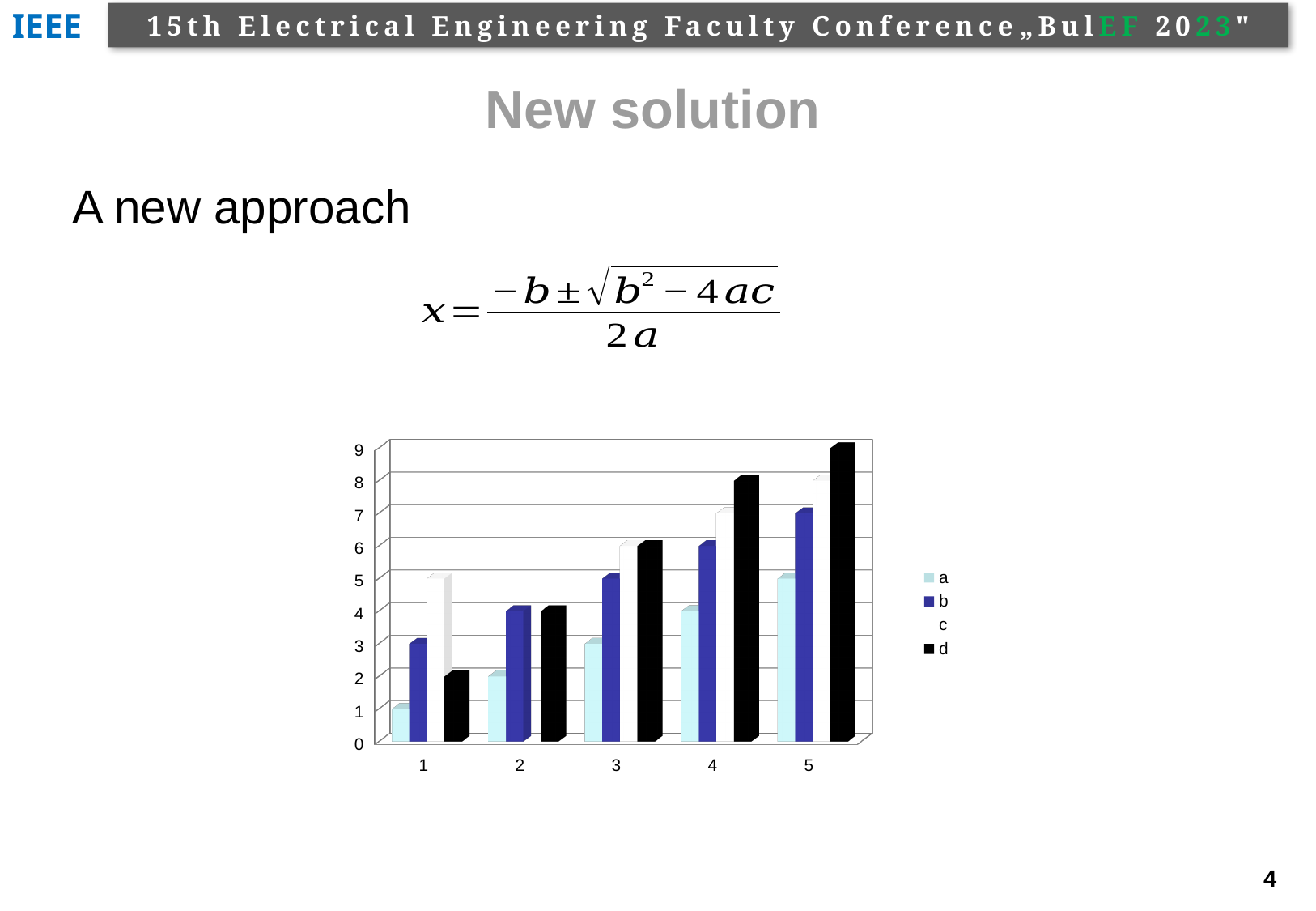
Do the values of series a rise or fall from category 1 to category 5? rise Which series is drawn in black in the chart? d Is the value of series b at category 1 greater or less than 2? greater What is the value of series d at category 1? 2 Is the value of series d at category 5 greater or less than 8? greater What is the value of series a at category 5? 5 What kind of chart is shown on the slide? bar chart How many series does the chart legend list? 4 At which category does series a have its lowest value? 1 How many categories are shown on the x axis of the chart? 5 At which category does series d have its highest value? 5 What is the value of series a at category 1? 1